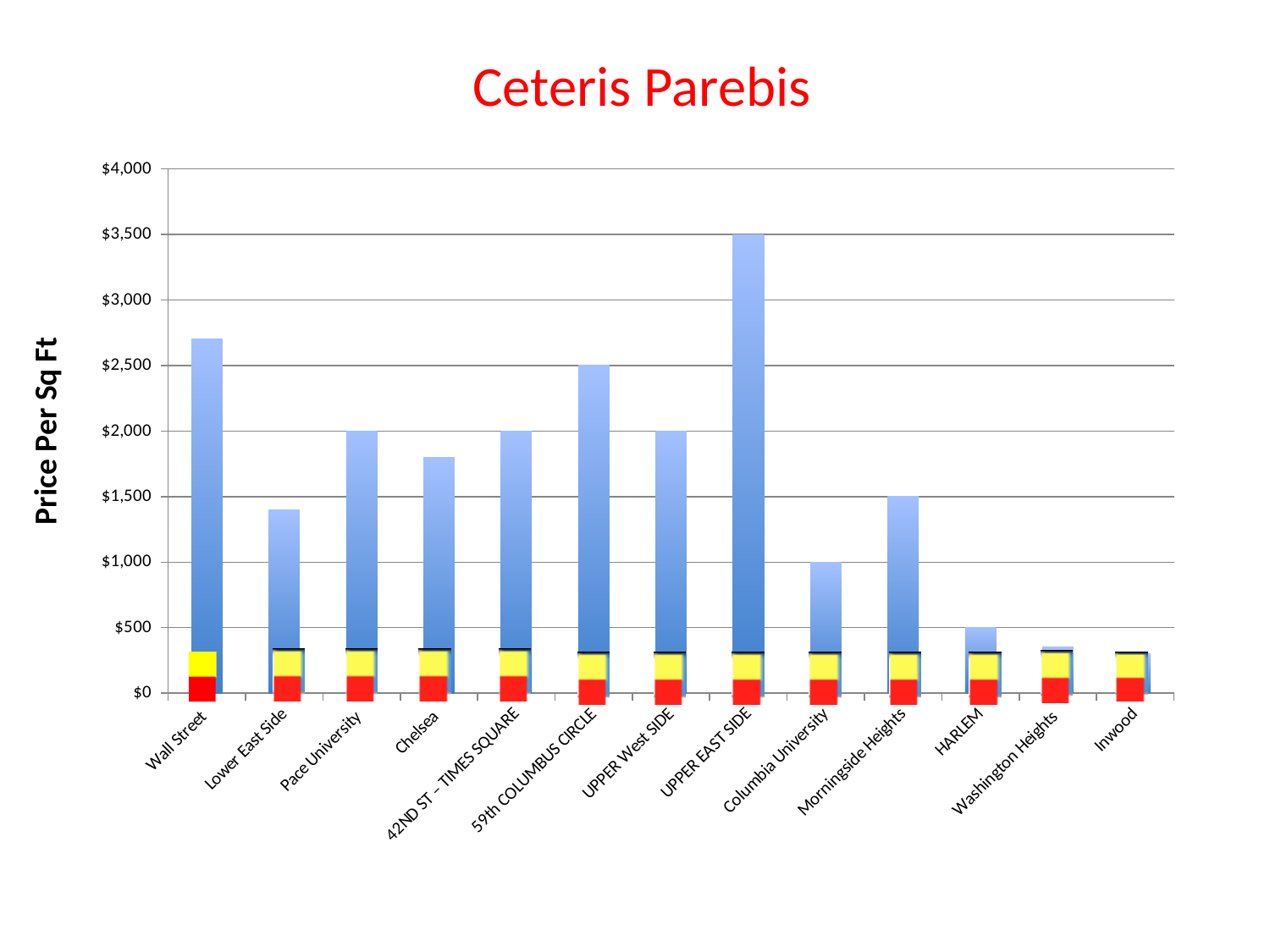
What is the price per square foot for HARLEM? $500 What is the price per square foot for 59th COLUMBUS CIRCLE? $2,500 Which has a higher price per square foot, Wall Street or 59th COLUMBUS CIRCLE? Wall Street How many neighborhoods (categories) are shown on the x axis? 13 What kind of chart is shown on the slide? bar chart What is the difference in price per square foot between UPPER EAST SIDE and Morningside Heights? $2,000 What is the label on the vertical axis? Price Per Sq Ft Which neighborhood has the highest price per square foot? UPPER EAST SIDE What is the title of the chart? Ceteris Parebis What is the price per square foot for Columbia University? $1,000 Is the value for Wall Street greater or less than $2,500? greater What is the price per square foot for UPPER EAST SIDE? $3,500